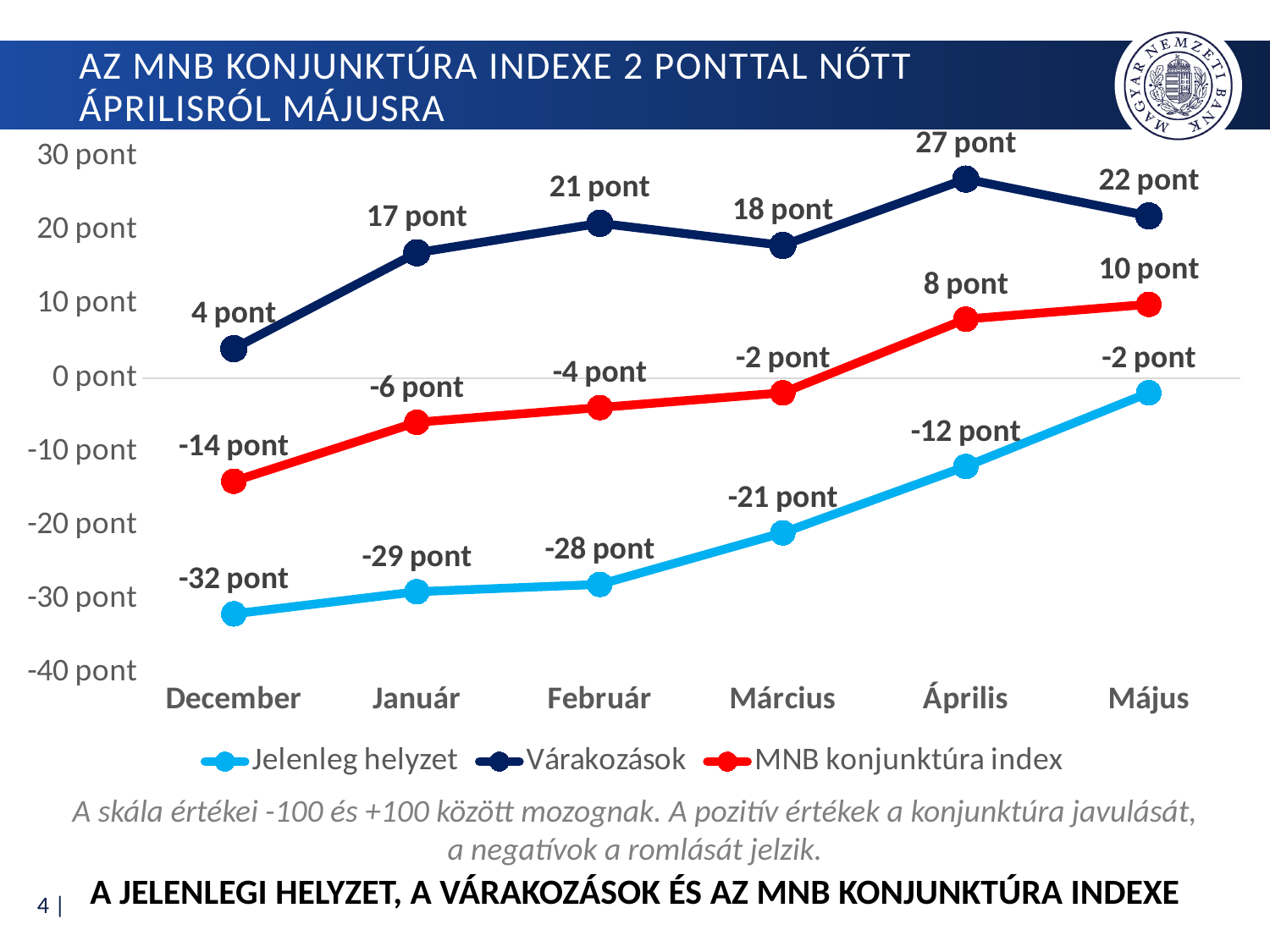
Does the Jelenleg helyzet series rise or fall from December to Május? Rise What kind of chart is shown on the slide? Line chart What is the difference between the MNB konjunktúra index in Május and in Április? 2 pont What is the value of Jelenleg helyzet in December? -32 pont How many months are shown on the x axis? 6 What colour is the line for the MNB konjunktúra index? Red In which month is the Várakozások series highest? Április What is the value of Várakozások in Február? 21 pont How many series does the legend list? 3 What is the value of the MNB konjunktúra index in Május? 10 pont In which month is the Jelenleg helyzet series lowest? December Which is larger in Március: Várakozások or the MNB konjunktúra index? Várakozások